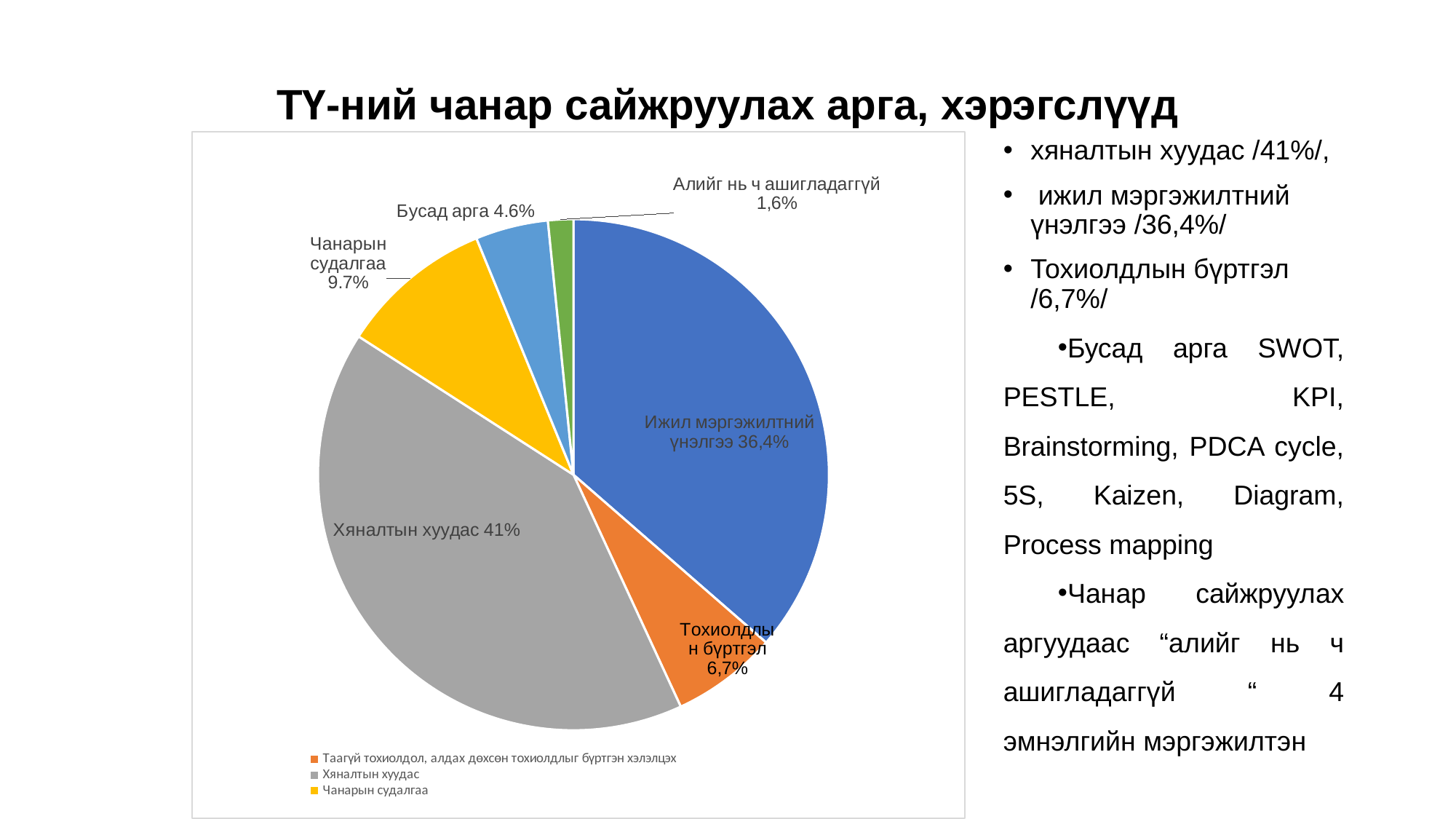
Which slice of the pie is the largest? Хяналтын хуудас What percentage is shown for Алийг нь ч ашигладаггүй? 1,6% What is the value shown for Ижил мэргэжилтний үнэлгээ? 36,4% What type of chart is shown on the slide? pie chart What share of the pie does Хяналтын хуудас have? 41% What colour is the Хяналтын хуудас slice? grey What percentage is labelled for Чанарын судалгаа? 9.7% Which slice of the pie is the smallest? Алийг нь ч ашигладаггүй What is the difference between Чанарын судалгаа (9.7%) and Бусад арга (4.6%)? 5.1% Which is larger, Чанарын судалгаа or Тохиолдлын бүртгэл? Чанарын судалгаа How many slices does the pie chart have? 6 What is the value for Бусад арга? 4.6%